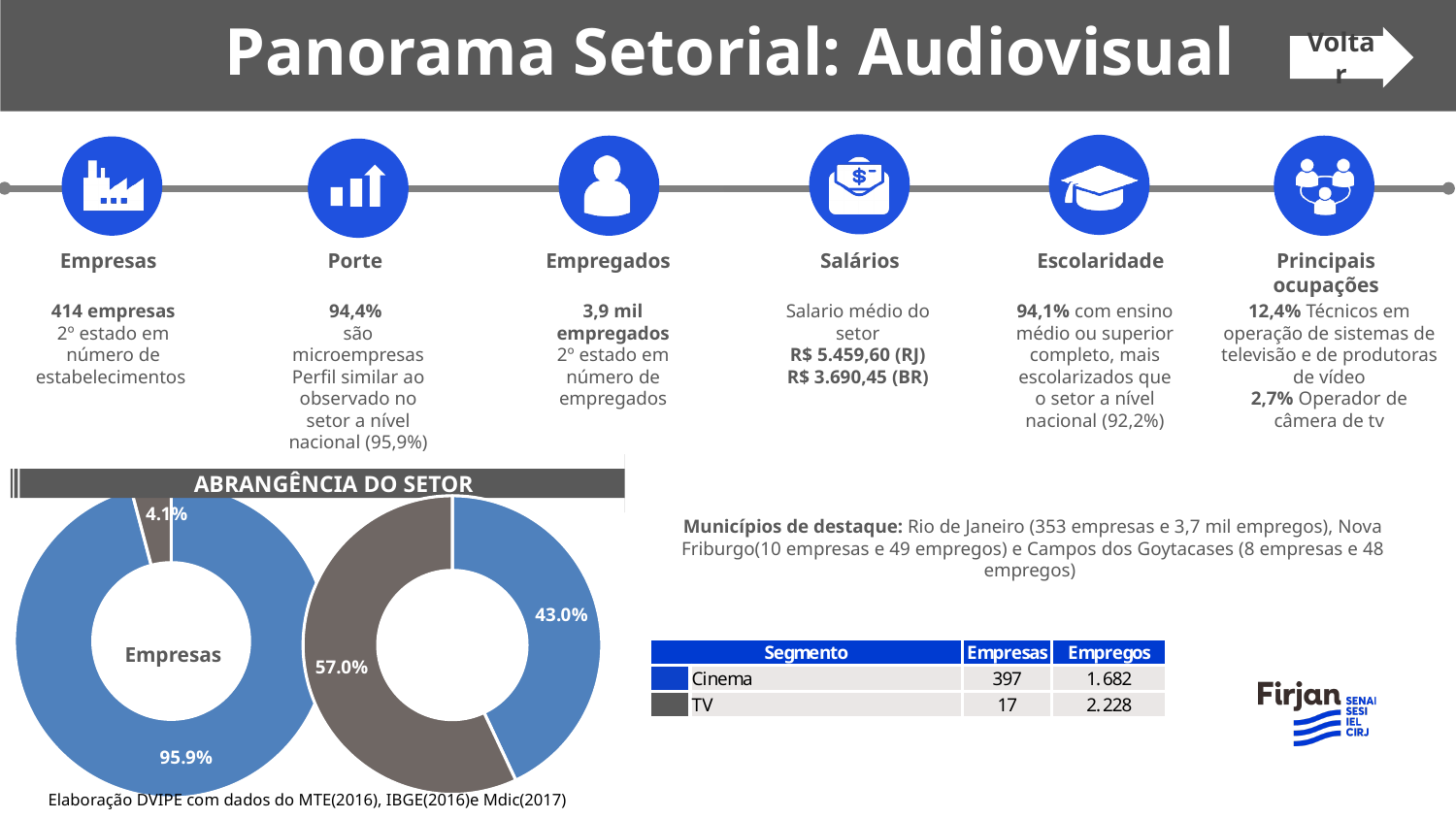
In the right-hand donut chart, what is the difference in percentage points between the grey slice and the blue slice? 14.0 percentage points In the right-hand donut chart, what share does the blue (Cinema) slice have? 43.0% In the right-hand donut chart, is the blue slice larger or smaller than the grey slice? Smaller In the right-hand donut chart, what share does the grey (TV) slice have? 57.0% What kind of chart is used in the "Abrangência do Setor" section? Pie (donut) chart How many slices does the "Empresas" donut chart have? 2 In the "Empresas" donut chart, which segment has the largest share? Cinema (blue), 95.9% How many donut charts are shown in the "Abrangência do Setor" section? 2 In the "Empresas" donut chart, what share does the blue (Cinema) slice have? 95.9% In the right-hand donut chart, which segment has the largest share? TV (grey), 57.0% In the "Empresas" donut chart, what is the difference in percentage points between the blue slice and the grey slice? 91.8 percentage points In the "Empresas" donut chart, what share does the grey (TV) slice have? 4.1%